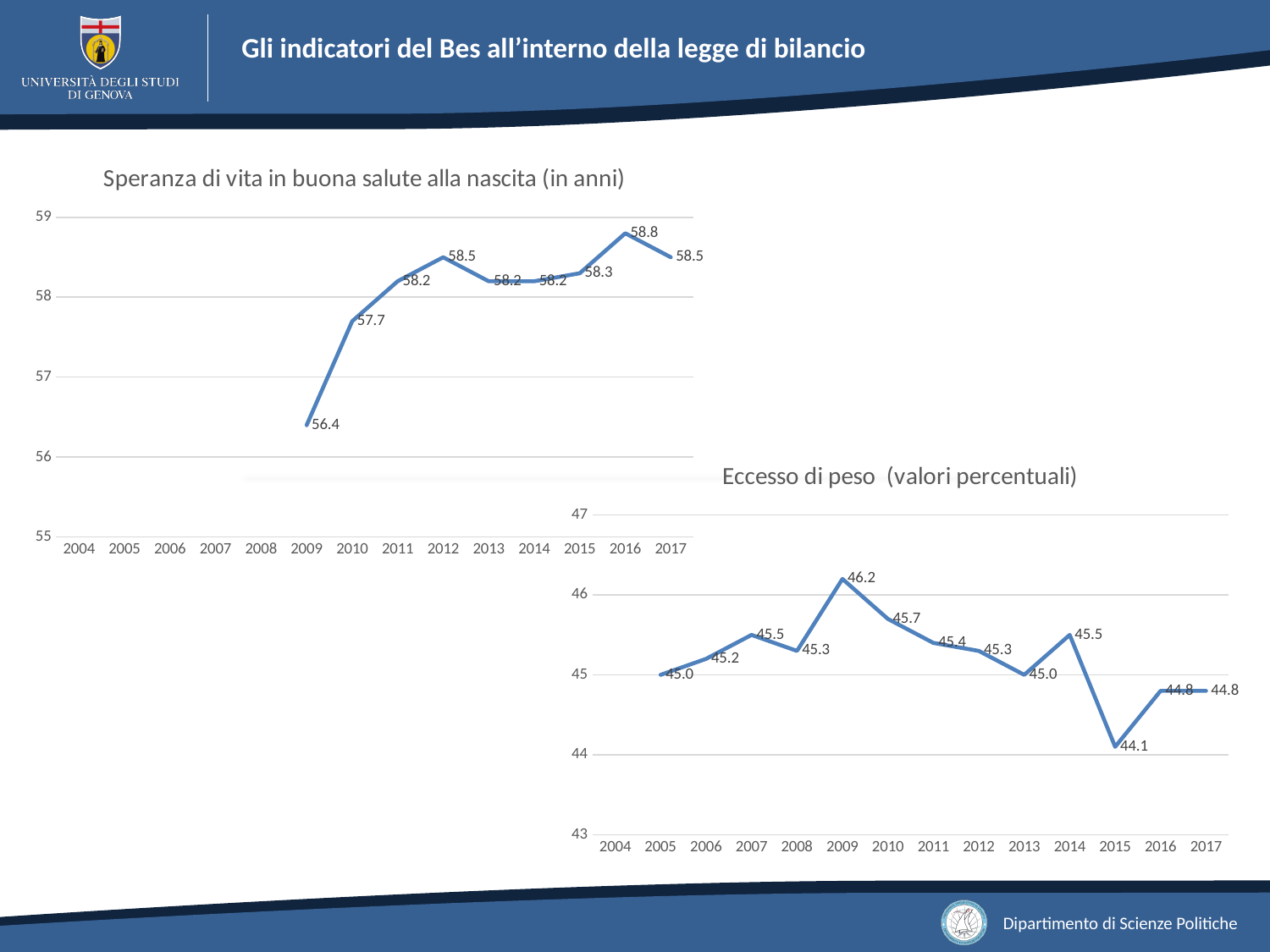
In the chart 'Eccesso di peso (valori percentuali)', what is the value for 2017? 44.8 In the chart 'Speranza di vita in buona salute alla nascita (in anni)', what is the value for 2009? 56.4 How many charts are shown on the slide? 2 In the chart 'Eccesso di peso (valori percentuali)', which year has the lowest value? 2015 In the chart 'Eccesso di peso (valori percentuali)', is the value for 2010 larger or smaller than the value for 2014? Larger In the chart 'Speranza di vita in buona salute alla nascita (in anni)', which year has the highest value? 2016 In the chart 'Speranza di vita in buona salute alla nascita (in anni)', what is the difference between the 2016 value and the 2009 value? 2.4 In the chart 'Eccesso di peso (valori percentuali)', what is the difference between the 2009 value and the 2015 value? 2.1 What kind of chart is 'Speranza di vita in buona salute alla nascita (in anni)'? Line chart In the chart 'Eccesso di peso (valori percentuali)', what is the value for 2009? 46.2 In the chart 'Eccesso di peso (valori percentuali)', is the value for 2015 greater or less than 45? less In the chart 'Speranza di vita in buona salute alla nascita (in anni)', what is the value for 2017? 58.5